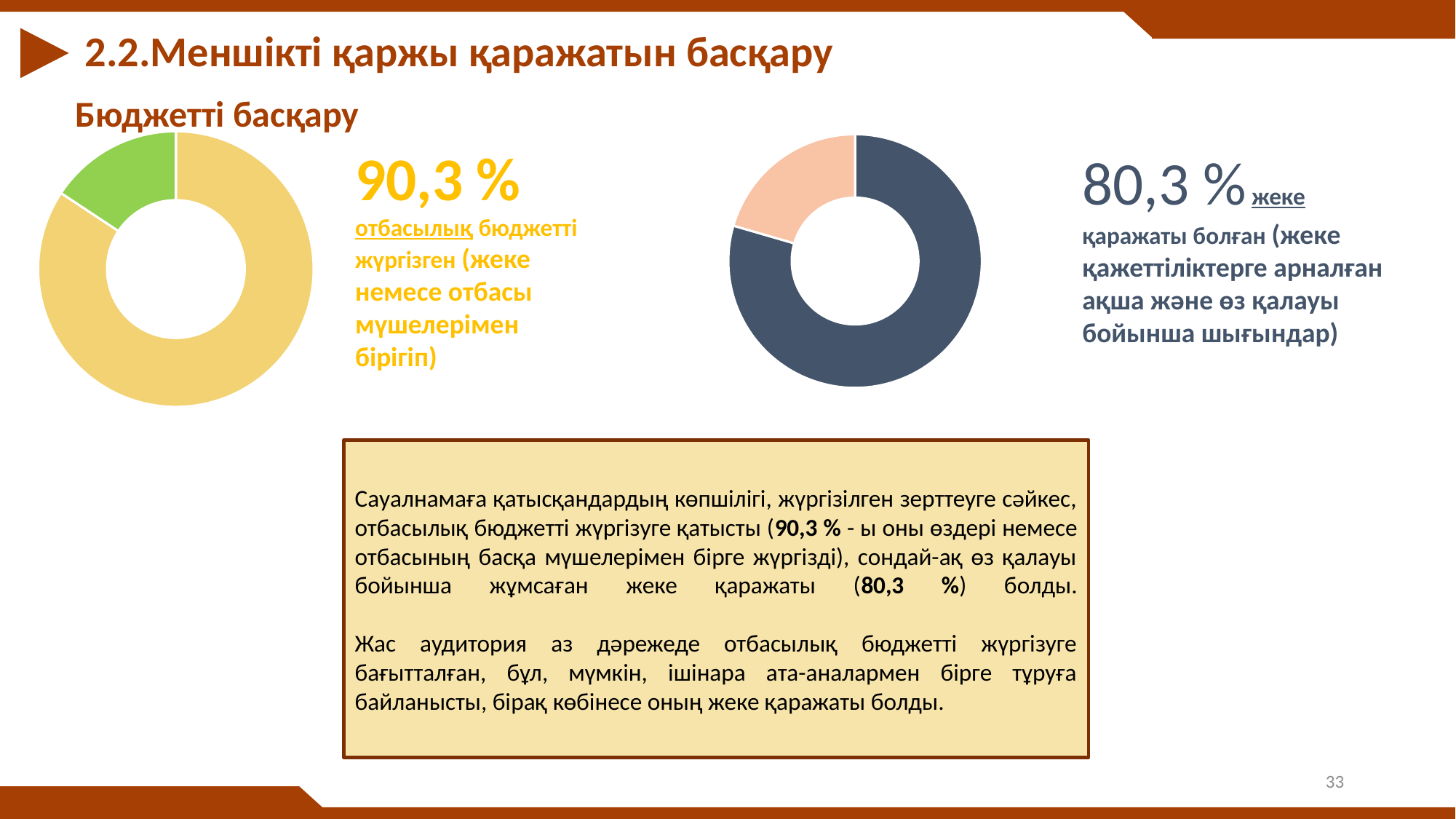
Which is larger: the main share in the left chart (90,3 %) or the main share in the right chart (80,3 %)? the left chart (90,3 %) In the right chart, which slice is larger, the dark blue one or the peach one? dark blue What heading is printed above the left chart? Бюджетті басқару What kind of chart is the chart on the right of the slide? doughnut chart In the left chart, which slice is larger, the yellow one or the green one? yellow How many slices does the left chart have? 2 What is the difference between the main share in the left chart (90,3 %) and the main share in the right chart (80,3 %)? 10 % What kind of chart is the chart on the left of the slide? doughnut chart In the left chart, is the green slice more or less than half of the pie? less How many slices does the right chart have? 2